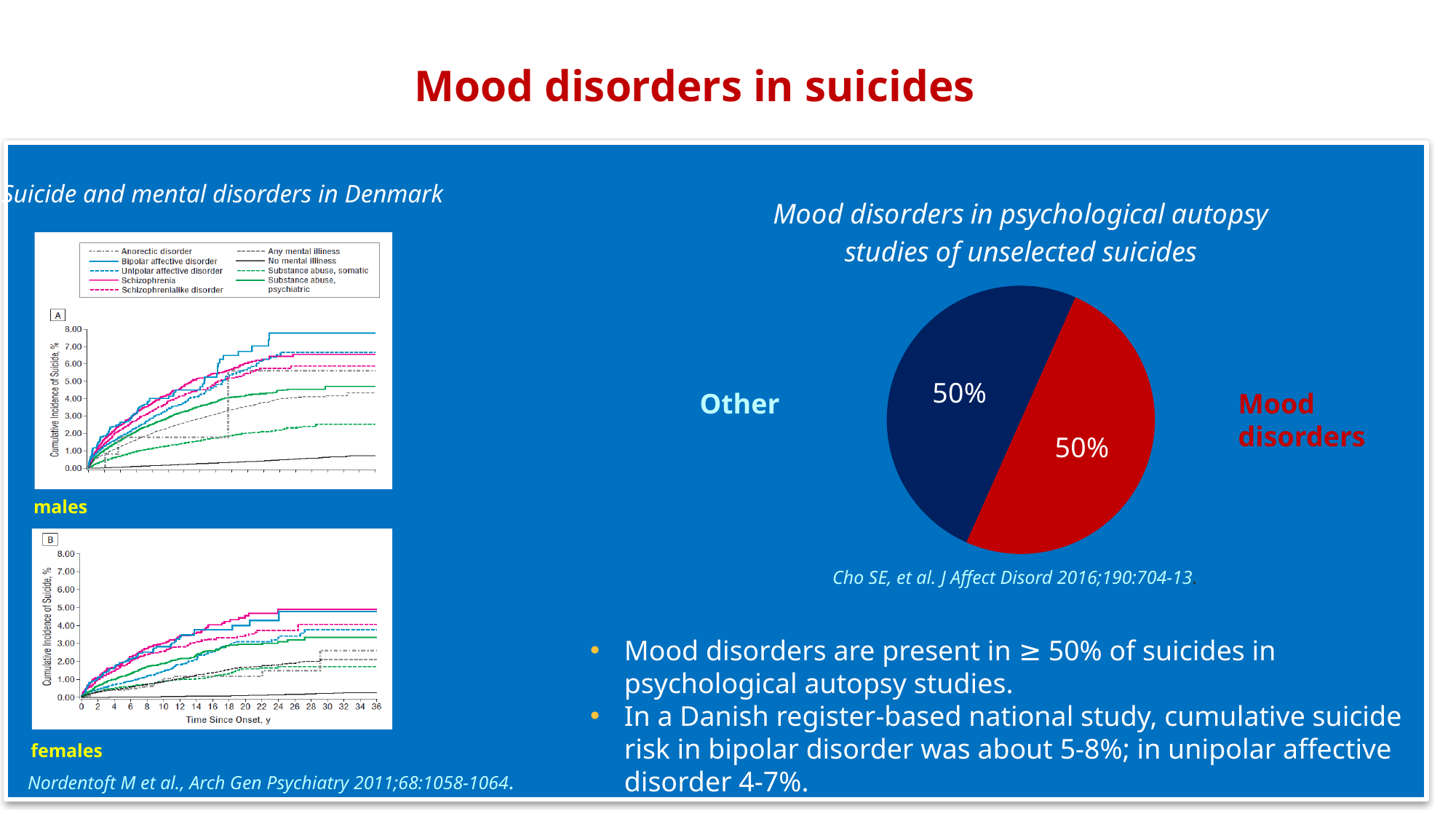
How many series does the legend of the 'Suicide and mental disorders in Denmark' charts list? 9 How many slices does the pie chart on the right of the slide have? 2 In the males chart (A) of 'Suicide and mental disorders in Denmark', which series has the lowest cumulative incidence of suicide? No mental illness In the 'Suicide and mental disorders in Denmark' charts, do the cumulative incidence curves rise or fall as time since onset increases? rise In the males chart (A) of 'Suicide and mental disorders in Denmark', is the final cumulative incidence for bipolar affective disorder greater or less than 7.00%? greater What kind of chart are the two 'Suicide and mental disorders in Denmark' charts on the left of the slide? line chart In the males chart (A) of 'Suicide and mental disorders in Denmark', which series reaches the highest cumulative incidence of suicide? Bipolar affective disorder In the females chart (B) of 'Suicide and mental disorders in Denmark', is the final cumulative incidence for no mental illness greater or less than 1.00%? less In the pie chart on the right, what colour is the 'Mood disorders' slice? red In the pie chart 'Mood disorders in psychological autopsy studies of unselected suicides', what share of suicides is attributed to mood disorders? 50% In the pie chart 'Mood disorders in psychological autopsy studies of unselected suicides', what share is labelled 'Other'? 50% What kind of chart is the 'Mood disorders in psychological autopsy studies of unselected suicides' chart? pie chart